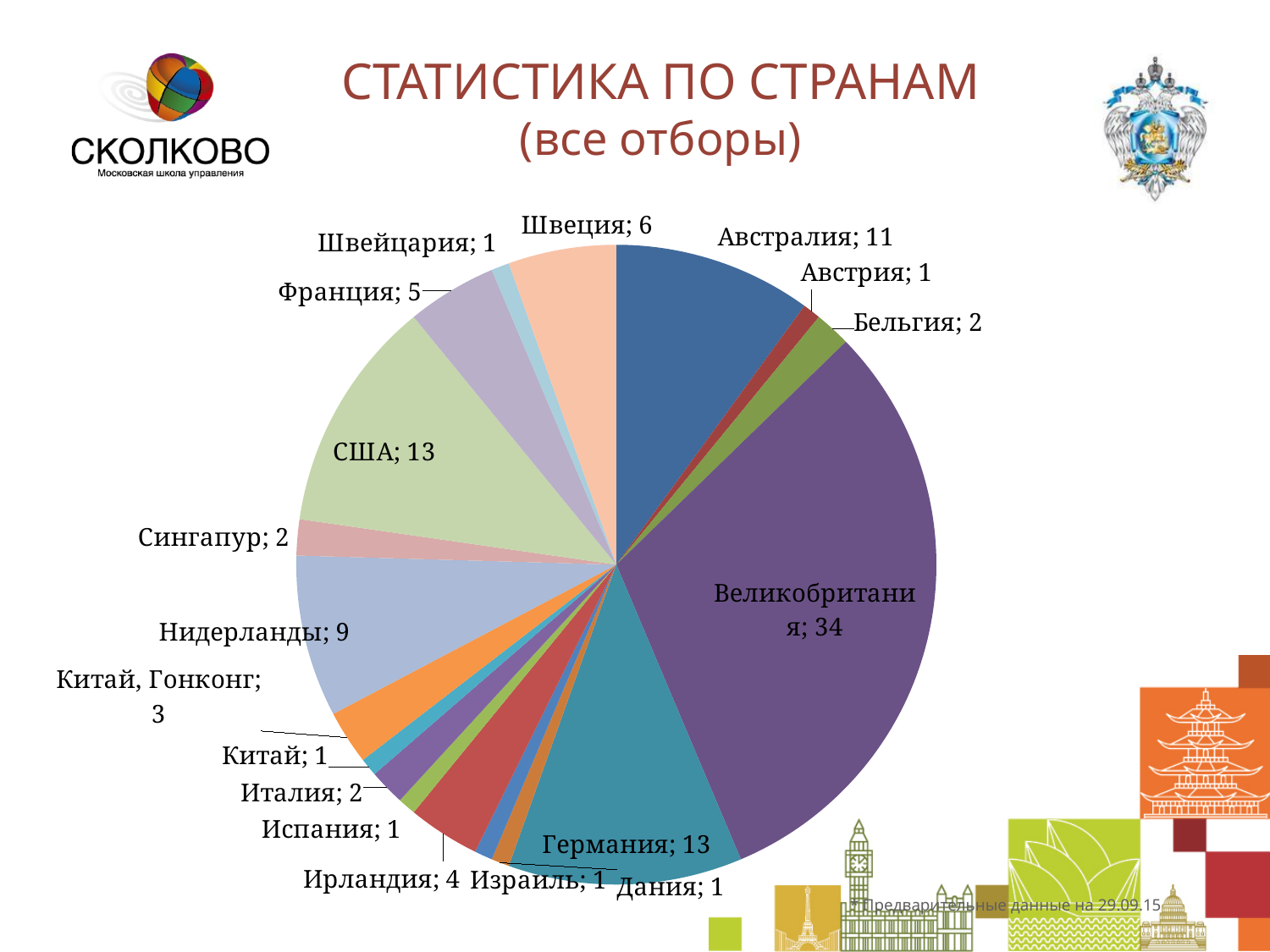
What is the title of the slide containing the chart? СТАТИСТИКА ПО СТРАНАМ (все отборы) Which country has the largest slice of the pie? Великобритания What is the difference between the values for Великобритания and Германия? 21 Which is larger, the value for Австралия or the value for Нидерланды? Австралия What is the value for Китай, Гонконг? 3 What is the value for Великобритания? 34 What is the value for Нидерланды? 9 What is the difference between the values for США and Франция? 8 Which is larger, the value for Ирландия or the value for Швеция? Швеция What is the value for Швеция? 6 How many countries (slices) are shown in the pie chart? 18 What kind of chart is shown on the slide? pie chart